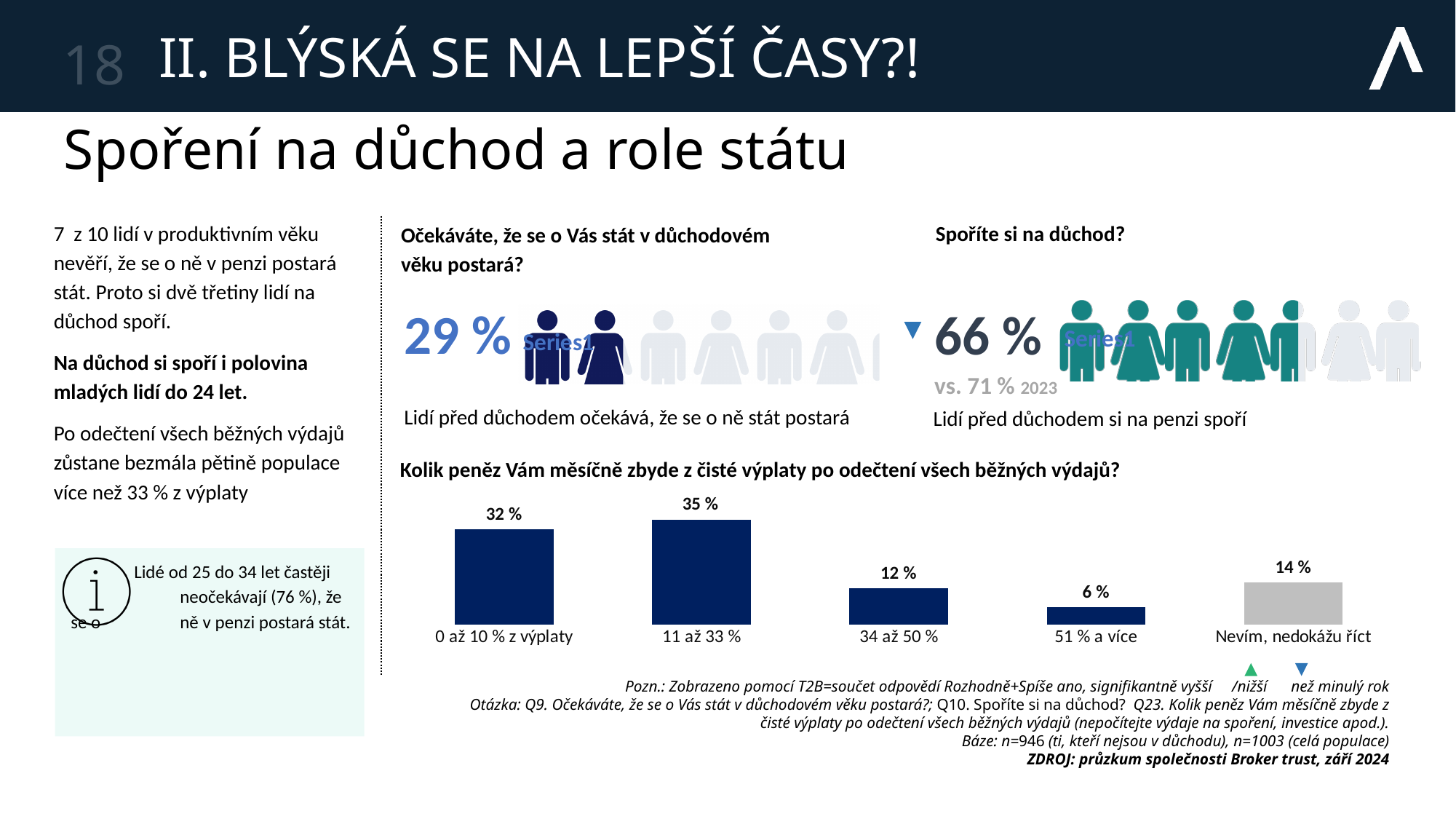
In the chart 'Kolik peněz Vám měsíčně zbyde z čisté výplaty po odečtení všech běžných výdajů?', which category has the highest value? 11 až 33 % In the pictograph chart 'Očekáváte, že se o Vás stát v důchodovém věku postará?', what percentage is shown? 29 % In the chart 'Kolik peněz Vám měsíčně zbyde z čisté výplaty po odečtení všech běžných výdajů?', which category has the lowest value? 51 % a více In the chart 'Kolik peněz Vám měsíčně zbyde z čisté výplaty po odečtení všech běžných výdajů?', what is the value for '11 až 33 %'? 35 % In the chart 'Kolik peněz Vám měsíčně zbyde z čisté výplaty po odečtení všech běžných výdajů?', which is larger: '34 až 50 %' or 'Nevím, nedokážu říct'? Nevím, nedokážu říct In the chart 'Kolik peněz Vám měsíčně zbyde z čisté výplaty po odečtení všech běžných výdajů?', what is the value for 'Nevím, nedokážu říct'? 14 % In the chart 'Kolik peněz Vám měsíčně zbyde z čisté výplaty po odečtení všech běžných výdajů?', what is the difference between '11 až 33 %' and '0 až 10 % z výplaty'? 3 % In the chart 'Kolik peněz Vám měsíčně zbyde z čisté výplaty po odečtení všech běžných výdajů?', what is the value for '0 až 10 % z výplaty'? 32 % How many categories are shown in the chart 'Kolik peněz Vám měsíčně zbyde z čisté výplaty po odečtení všech běžných výdajů?'? 5 In the pictograph chart 'Spoříte si na důchod?', what percentage is shown for the current year? 66 % In the chart 'Kolik peněz Vám měsíčně zbyde z čisté výplaty po odečtení všech běžných výdajů?', what is the difference between '34 až 50 %' and '51 % a více'? 6 % What kind of chart is 'Kolik peněz Vám měsíčně zbyde z čisté výplaty po odečtení všech běžných výdajů?'? Bar chart